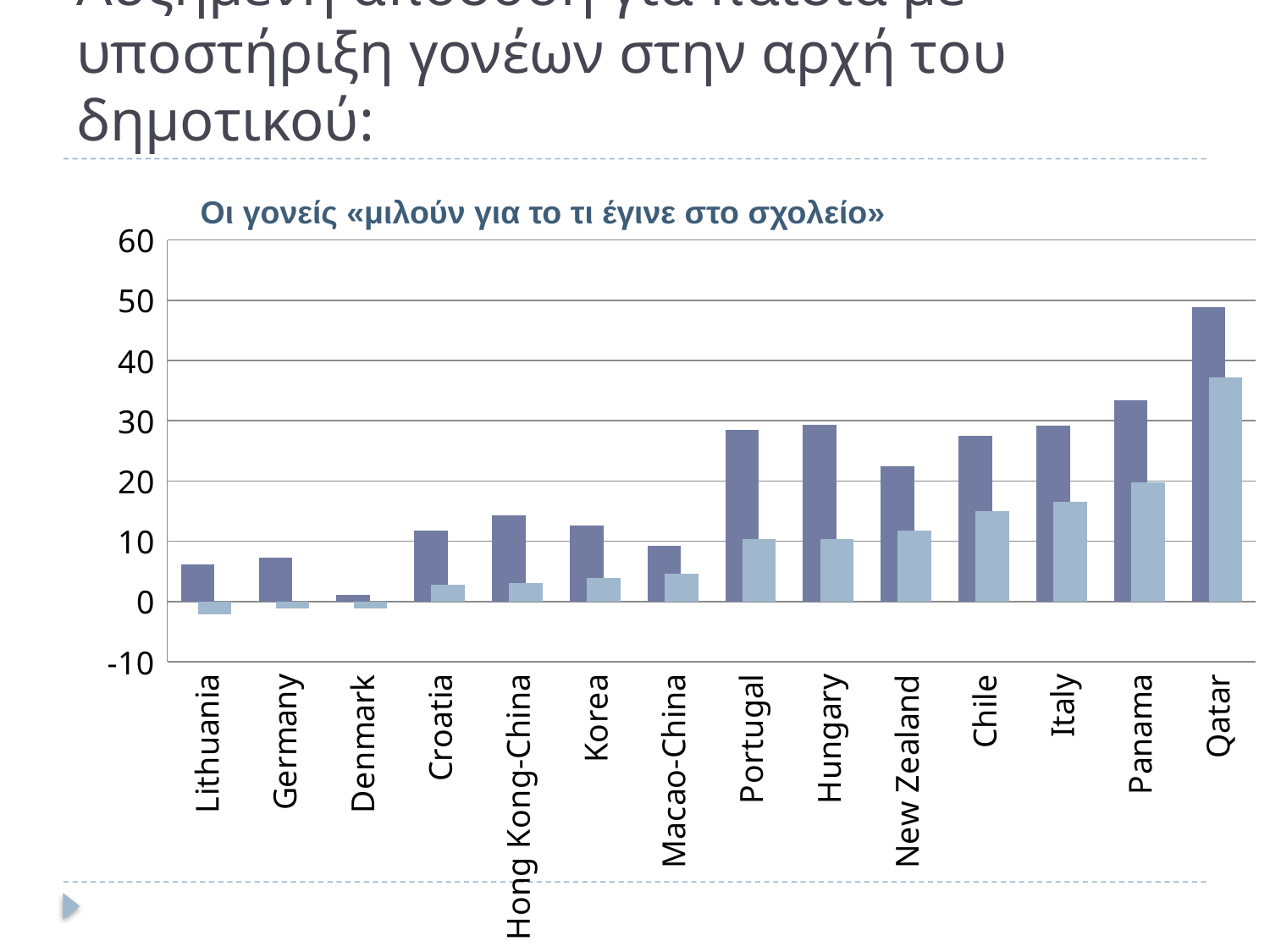
Is the dark blue bar for Qatar greater or less than 40? greater Is the light blue bar for Qatar greater or less than 30? greater Which country has the highest light blue bar? Qatar What is the title of the chart? Οι γονείς «μιλούν για το τι έγινε στο σχολείο» Which has the larger dark blue bar, Panama or Hungary? Panama How many countries are shown on the x axis of the chart? 14 Which country has the lowest dark blue bar? Denmark Do the dark blue bars generally rise or fall from Lithuania to Qatar along the x axis? rise Which country has the highest dark blue bar? Qatar What kind of chart is shown on the slide? bar chart Is the dark blue bar for Portugal greater or less than 30? less